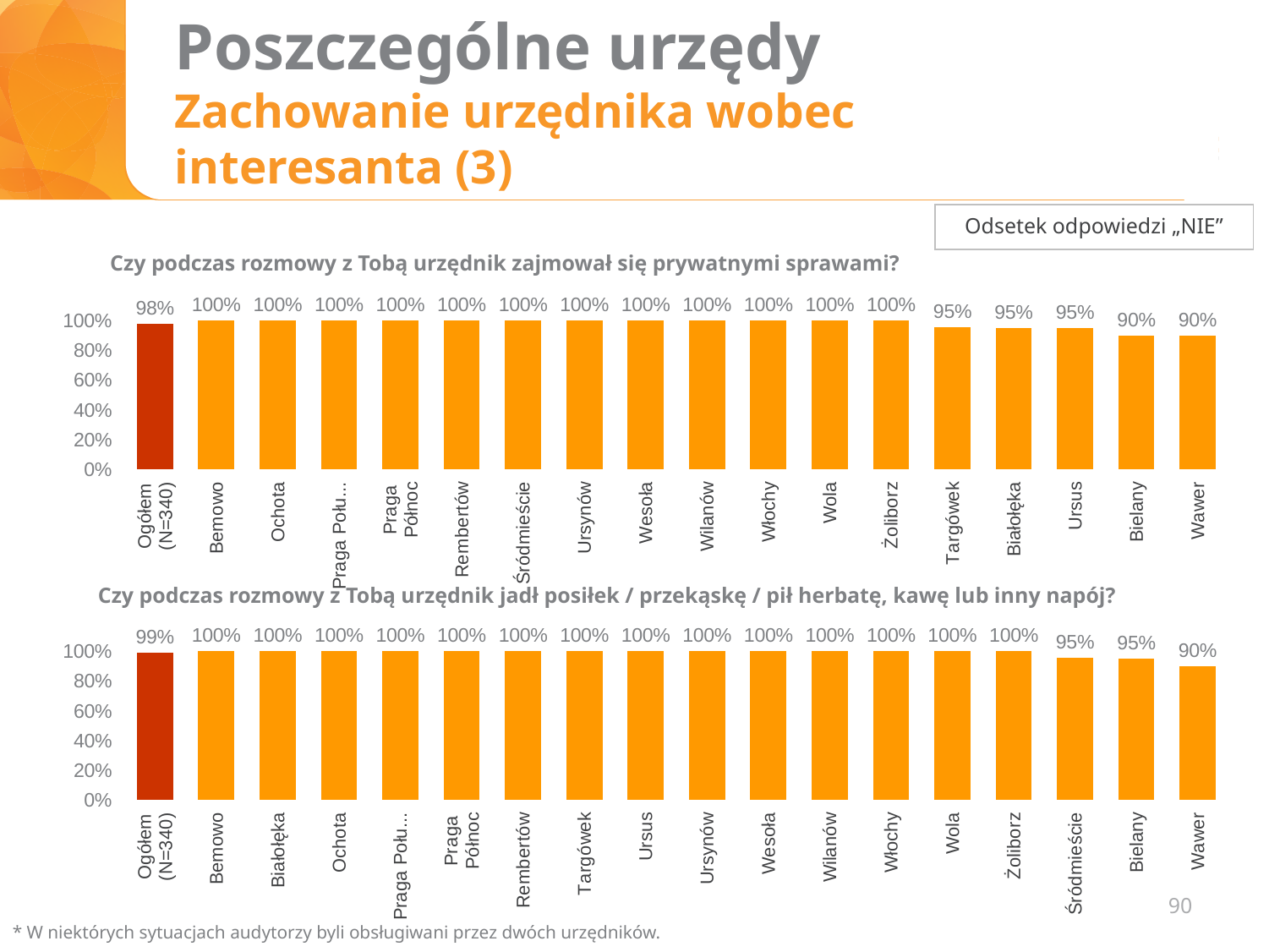
In the top chart, what is the value for Wawer? 90% In the bottom chart, which category has the lowest value? Wawer What type of chart is the top chart? Bar chart In the top chart ("Czy podczas rozmowy z Tobą urzędnik zajmował się prywatnymi sprawami?"), what is the value for Ogółem (N=340)? 98% How many categories are shown on the x axis of the bottom chart? 18 In the bottom chart ("Czy podczas rozmowy z Tobą urzędnik jadł posiłek / przekąskę / pił herbatę, kawę lub inny napój?"), what is the value for Ogółem (N=340)? 99% In the top chart, which is larger, the value for Ursus or the value for Bielany? Ursus In the bottom chart, what is the difference between the values for Bemowo and Wawer? 10% In the top chart, what is the value for Targówek? 95% In the top chart, what is the difference between the values for Ogółem (N=340) and Bielany? 8% In the bottom chart, what is the value for Śródmieście? 95% According to the box in the top right of the slide, what do the percentages represent? Odsetek odpowiedzi „NIE”